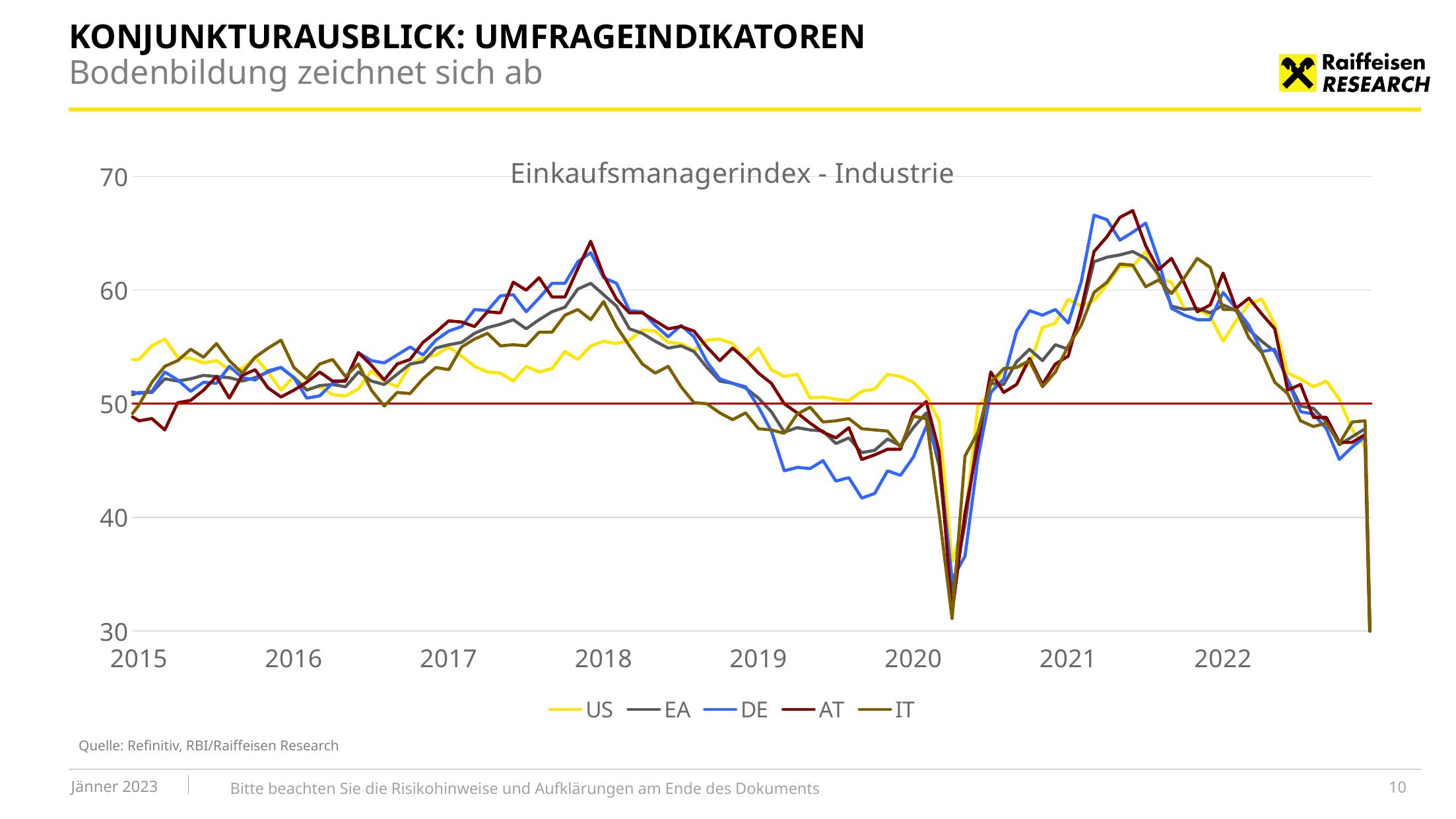
How many series does the legend of the chart list? 5 At what value is the horizontal red reference line drawn on the chart? 50 What kind of chart is shown on the slide? line chart Is the peak value of the AT series in 2021 greater or less than 60? greater How many year labels are shown on the x axis of the chart? 8 From the start of 2016 to the start of 2018, does the AT series rise or fall? rise Is the lowest value of the DE series in late 2019 greater or less than 45? less From the peak in 2021 to the end of 2022, do the values of the series rise or fall? fall What is the title of the chart? Einkaufsmanagerindex - Industrie Is the peak value of the US series in 2018 greater or less than 60? less At the peak around the start of 2018, which series is higher, DE or US? DE